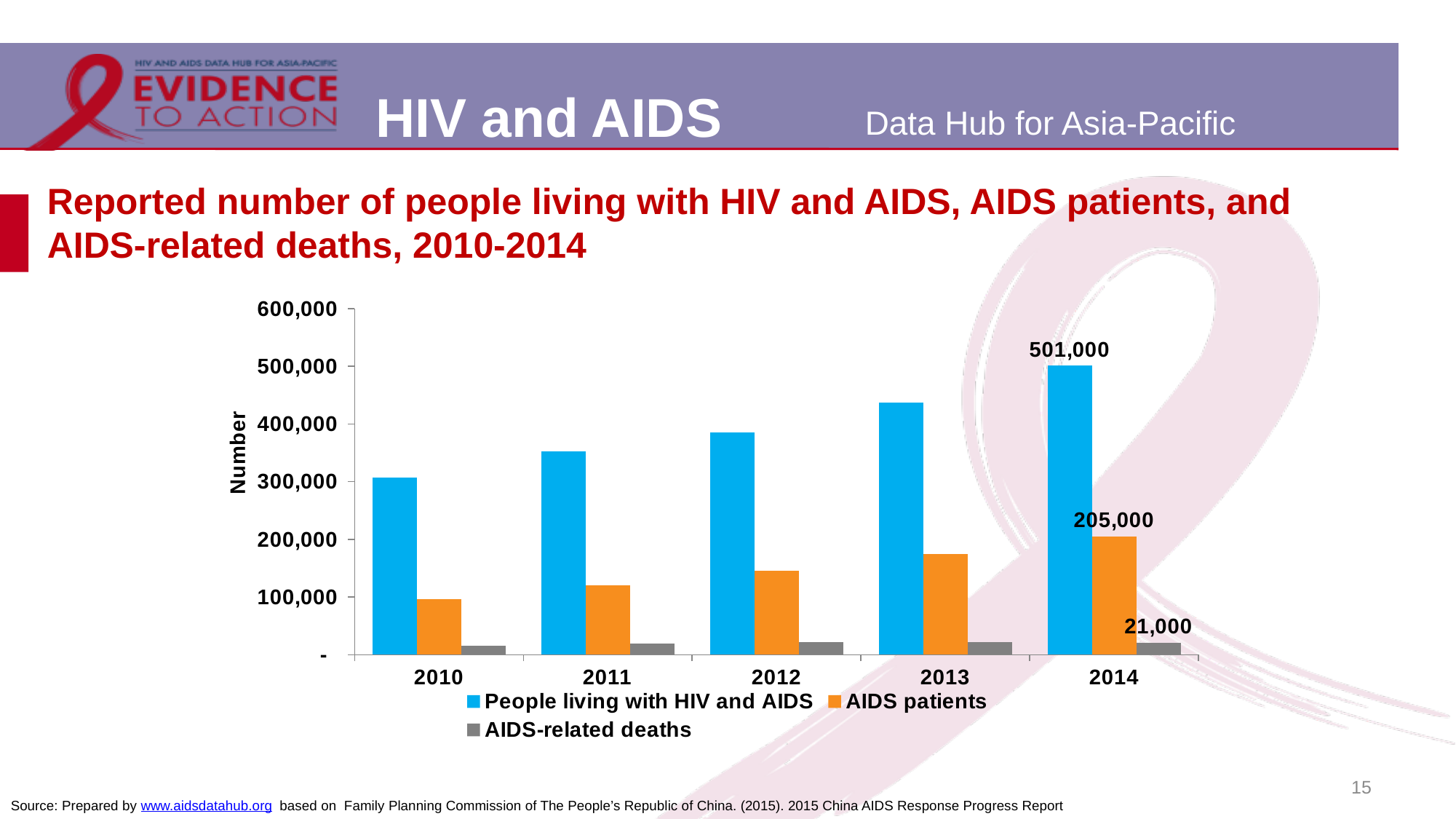
Does the number of people living with HIV and AIDS rise or fall from 2010 to 2014? rise What is the reported number of AIDS patients in 2014? 205,000 What is the reported number of AIDS-related deaths in 2014? 21,000 How many series does the chart's legend list? 3 Which year has more AIDS patients, 2012 or 2013? 2013 How many years are shown on the x axis of the chart? 5 Is the number of people living with HIV and AIDS in 2013 greater or less than 400,000? greater In which year is the number of people living with HIV and AIDS highest? 2014 In 2014, how much larger is the number of people living with HIV and AIDS than the number of AIDS patients? 296,000 In which year is the number of people living with HIV and AIDS lowest? 2010 What is the reported number of people living with HIV and AIDS in 2014? 501,000 Is the number of people living with HIV and AIDS in 2012 greater or less than 400,000? less